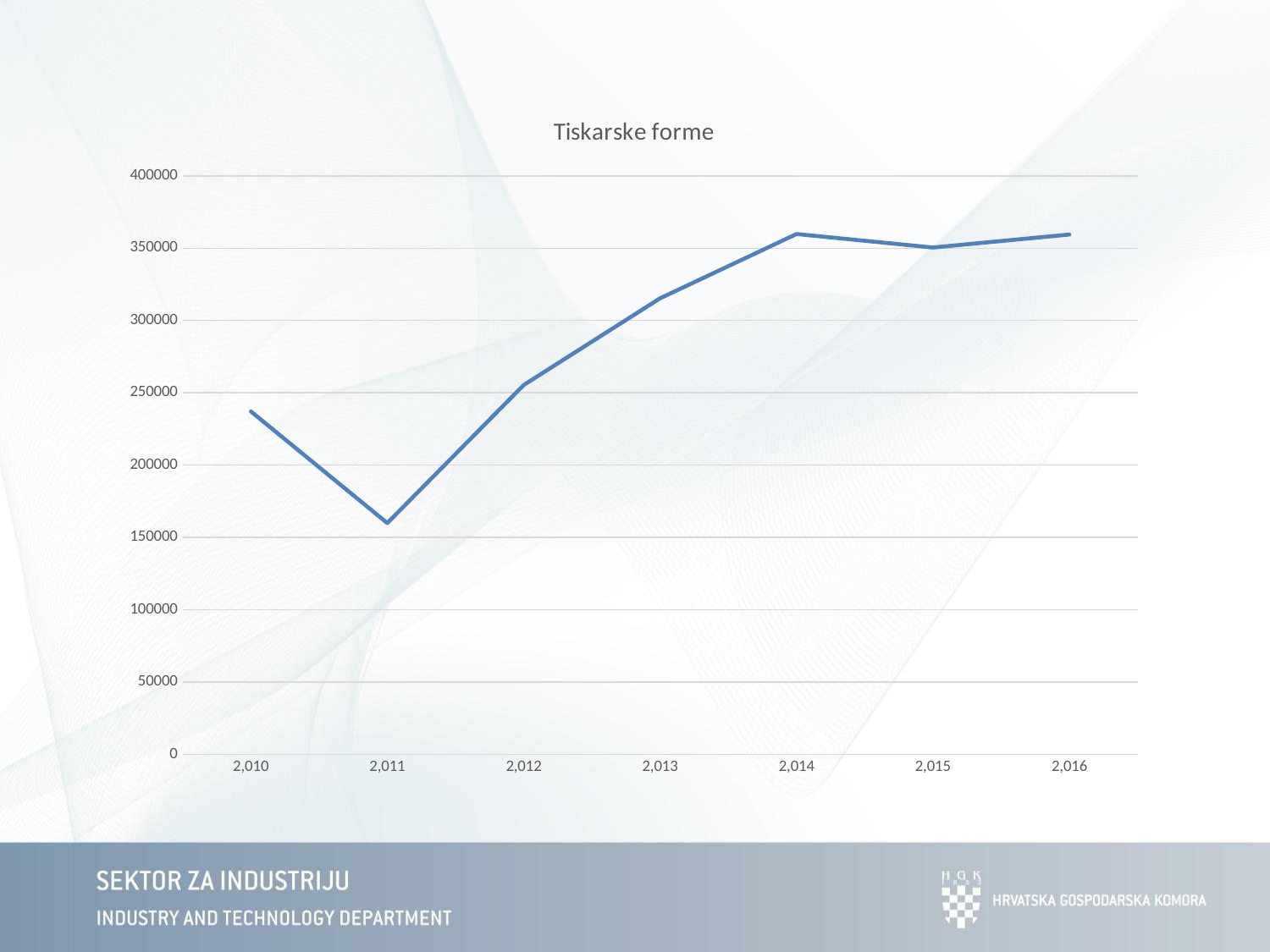
Which year has the lowest value in the chart? 2,011 What is the title of the chart? Tiskarske forme How many years are plotted on the x axis of the chart? 7 Is the value for 2,010 greater or less than 200000? greater Is the value for 2,010 greater or less than 250000? less Which year has the larger value, 2,010 or 2,012? 2,012 Is the value for 2,011 greater or less than 200000? less Do the values rise or fall from 2,011 to 2,014? rise What kind of chart is shown on the slide? line chart Which year has the larger value, 2,011 or 2,013? 2,013